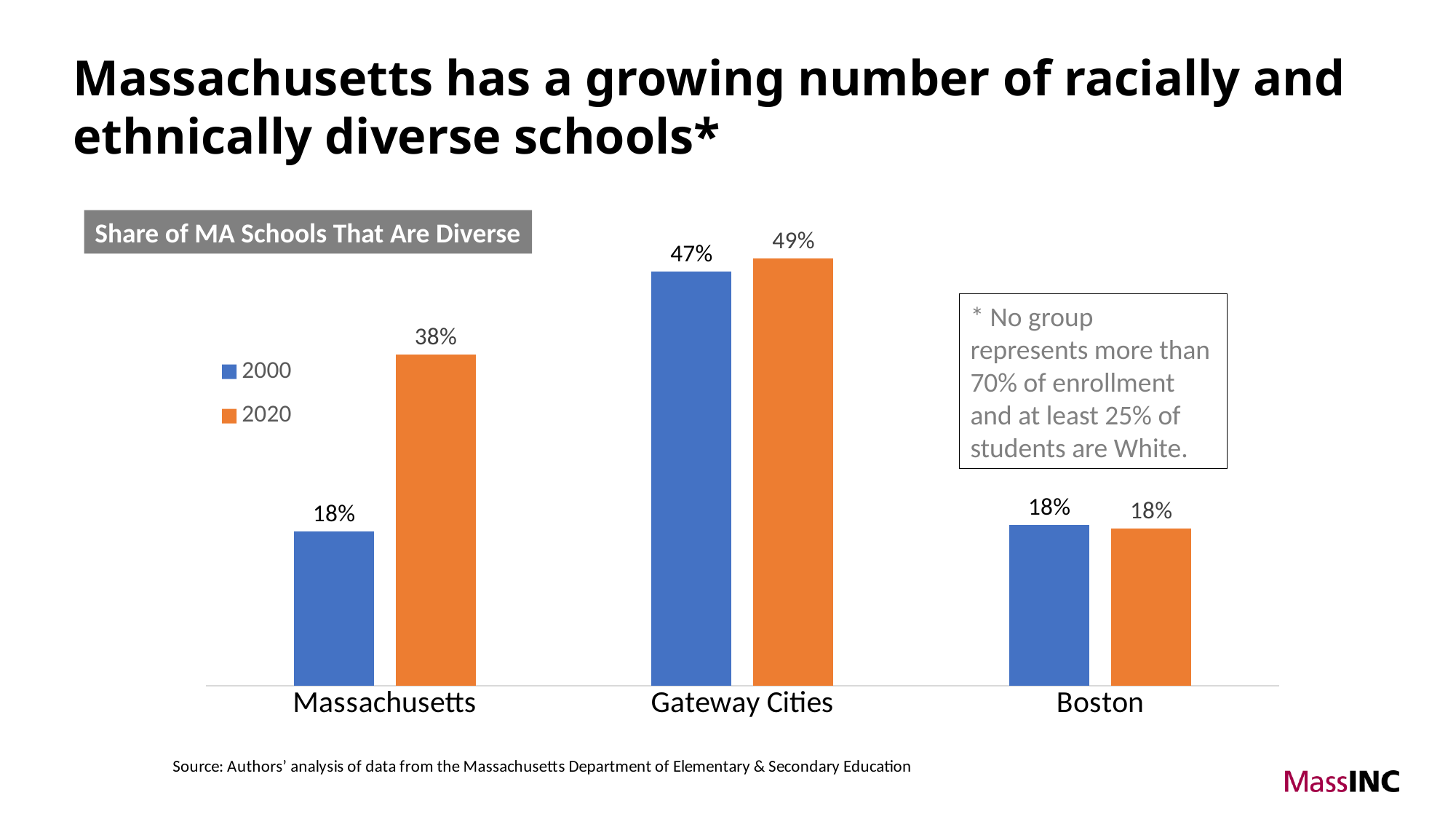
Which category has the highest share of diverse schools in 2020? Gateway Cities What is the share of diverse schools in Massachusetts in 2020? 38% What is the share of diverse schools in Massachusetts in 2000? 18% Which category has the lowest share of diverse schools in 2020? Boston What is the difference between the 2000 and 2020 values for Gateway Cities? 2 percentage points How many categories are shown on the x axis? 3 How many series does the legend list? 2 By how many percentage points did the share of diverse schools in Massachusetts change from 2000 to 2020? 20 percentage points What is the share of diverse schools in Boston in 2000? 18% What is the share of diverse schools in Gateway Cities in 2020? 49% What type of chart is shown on the slide? Bar chart Which is larger: the 2020 value for Massachusetts or the 2020 value for Boston? Massachusetts